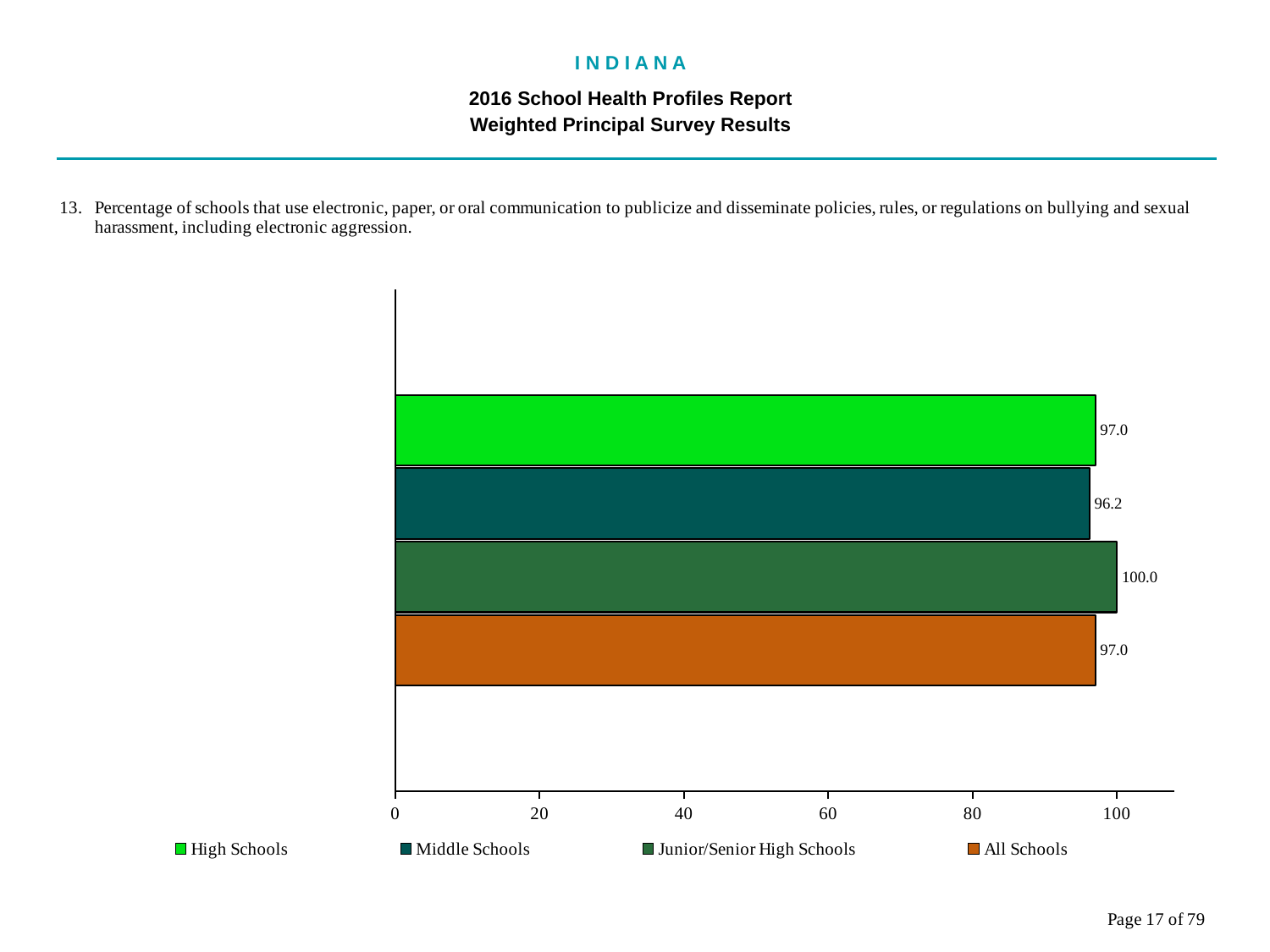
What is the difference between the values for Junior/Senior High Schools and Middle Schools? 3.8 What kind of chart is shown on the slide? Bar chart What is the difference between the values for High Schools and Middle Schools? 0.8 What is the value for High Schools? 97.0 What is the value for All Schools? 97.0 How many entries does the legend list? 4 What is the value for Middle Schools? 96.2 What is the value for Junior/Senior High Schools? 100.0 Is the value for Middle Schools greater or less than 80? greater How many bars are shown in the chart? 4 Which school category has the highest value? Junior/Senior High Schools Which school category has the lowest value? Middle Schools